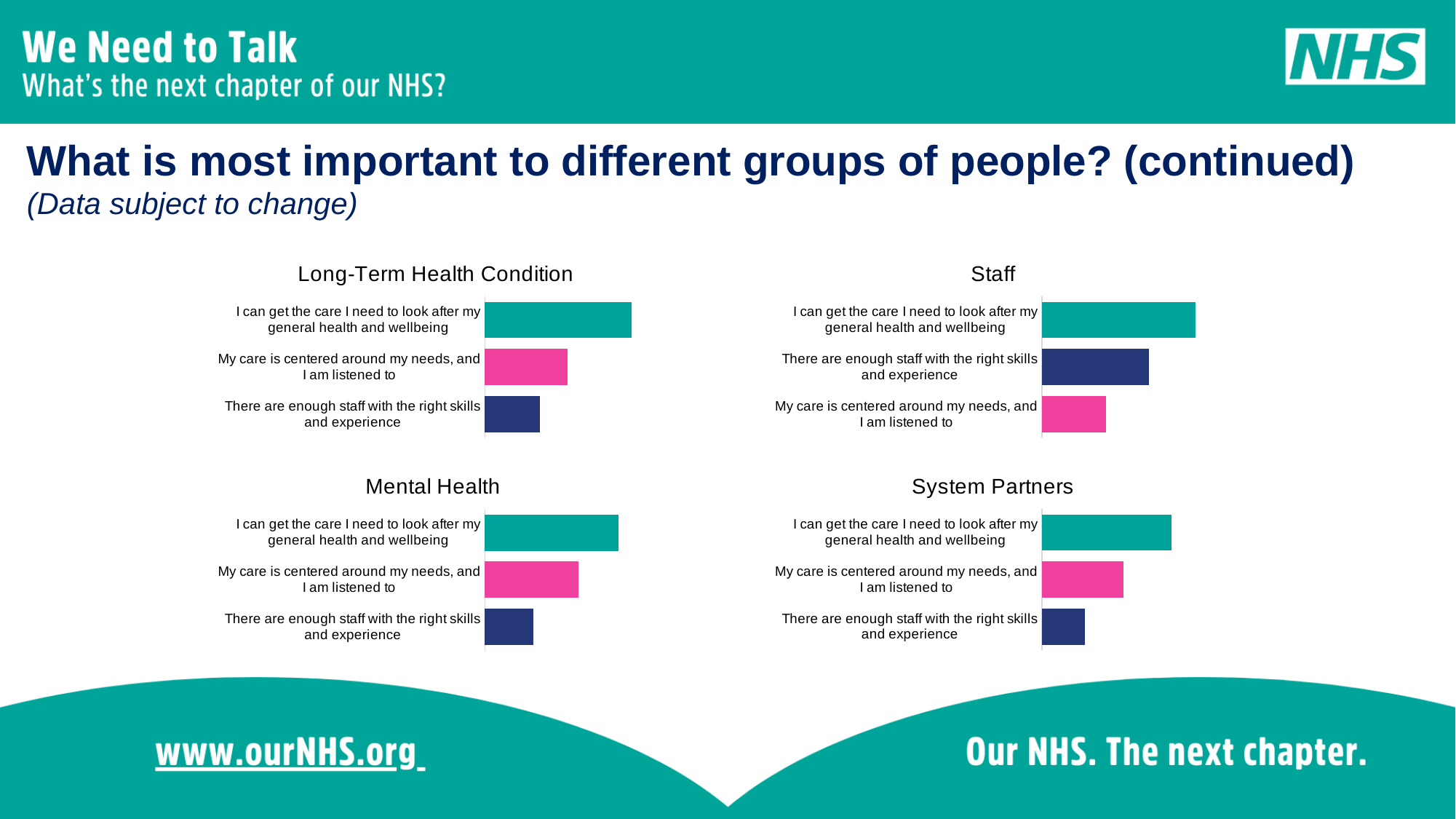
In the "Mental Health" chart, which category has the shortest bar? There are enough staff with the right skills and experience In the "Long-Term Health Condition" chart, which category has the longest bar? I can get the care I need to look after my general health and wellbeing In the "Staff" chart, which category has the lowest value? My care is centered around my needs, and I am listened to In the "Long-Term Health Condition" chart, which category has the shortest bar? There are enough staff with the right skills and experience In the "System Partners" chart, what colour is the bar for "There are enough staff with the right skills and experience"? Dark blue In the "Staff" chart, which is larger: "There are enough staff with the right skills and experience" or "My care is centered around my needs, and I am listened to"? There are enough staff with the right skills and experience What kind of chart is the "Long-Term Health Condition" chart? Bar chart In the "Mental Health" chart, which is larger: "I can get the care I need to look after my general health and wellbeing" or "My care is centered around my needs, and I am listened to"? I can get the care I need to look after my general health and wellbeing How many categories are shown in the "Staff" chart? 3 In the "System Partners" chart, which category has the highest value? I can get the care I need to look after my general health and wellbeing How many charts are shown on the slide? 4 In the "Staff" chart, which category has the highest value? I can get the care I need to look after my general health and wellbeing